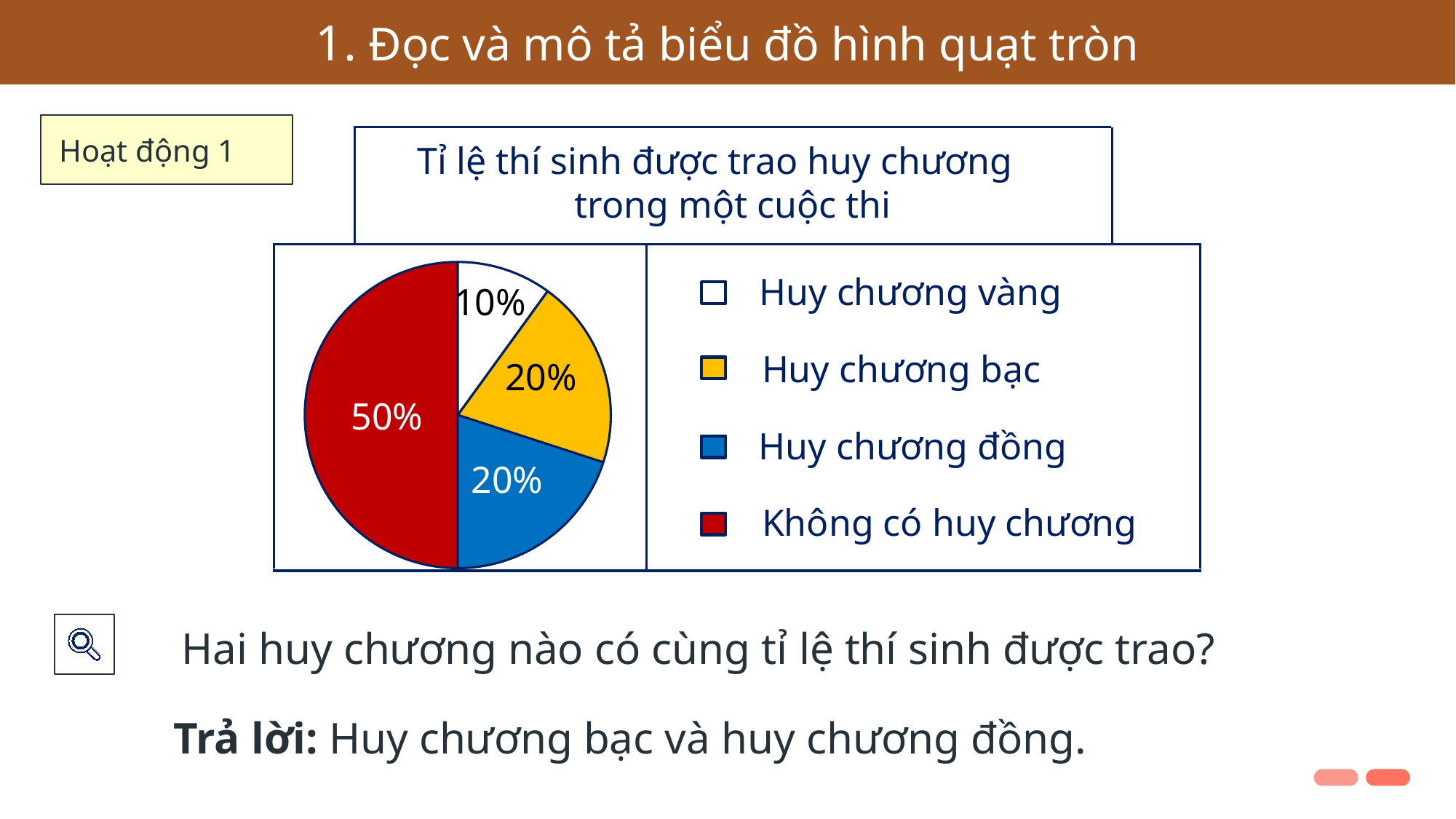
Which is larger, the share for Huy chương bạc or the share for Huy chương vàng? Huy chương bạc What colour is the slice for Không có huy chương? Red What percentage of the pie is labelled for Huy chương đồng? 20% What percentage of the pie is labelled for Huy chương bạc? 20% Which category has the smallest slice of the pie? Huy chương vàng Which category has the largest slice of the pie? Không có huy chương What kind of chart is shown on the slide? Pie chart What percentage of the pie is labelled for Huy chương vàng? 10% What is the title of the chart? Tỉ lệ thí sinh được trao huy chương trong một cuộc thi What percentage of the pie is labelled for Không có huy chương? 50% What is the difference between the share for Không có huy chương and the share for Huy chương vàng? 40% How many categories does the legend list? 4